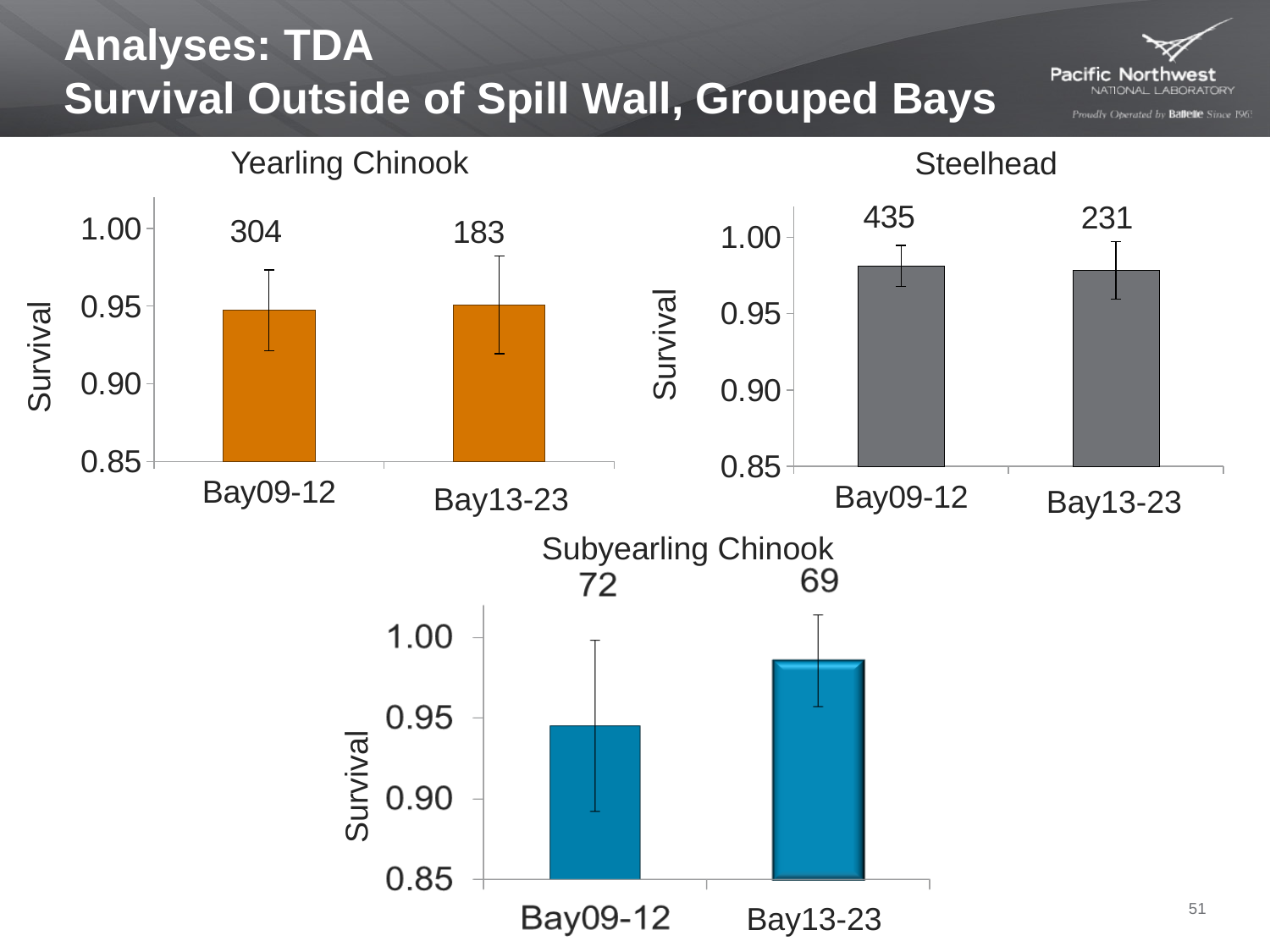
In the Steelhead chart, what number is printed above the Bay09-12 bar? 435 In the Subyearling Chinook chart, is the survival value for Bay13-23 greater or less than 0.95? greater In the Yearling Chinook chart, is the survival value for Bay09-12 greater or less than 0.90? greater In the Steelhead chart, what number is printed above the Bay13-23 bar? 231 In the Yearling Chinook chart, what number is printed above the Bay13-23 bar? 183 In the Yearling Chinook chart, what number is printed above the Bay09-12 bar? 304 In the Subyearling Chinook chart, what number is printed above the Bay13-23 bar? 69 How many bay groups are shown on the x axis of the Steelhead chart? 2 In the Subyearling Chinook chart, which bay group has the higher survival bar, Bay09-12 or Bay13-23? Bay13-23 In the Steelhead chart, is the survival value for Bay09-12 greater or less than 0.95? greater What is the y-axis label on the Subyearling Chinook chart? Survival What kind of chart is the Yearling Chinook chart? bar chart